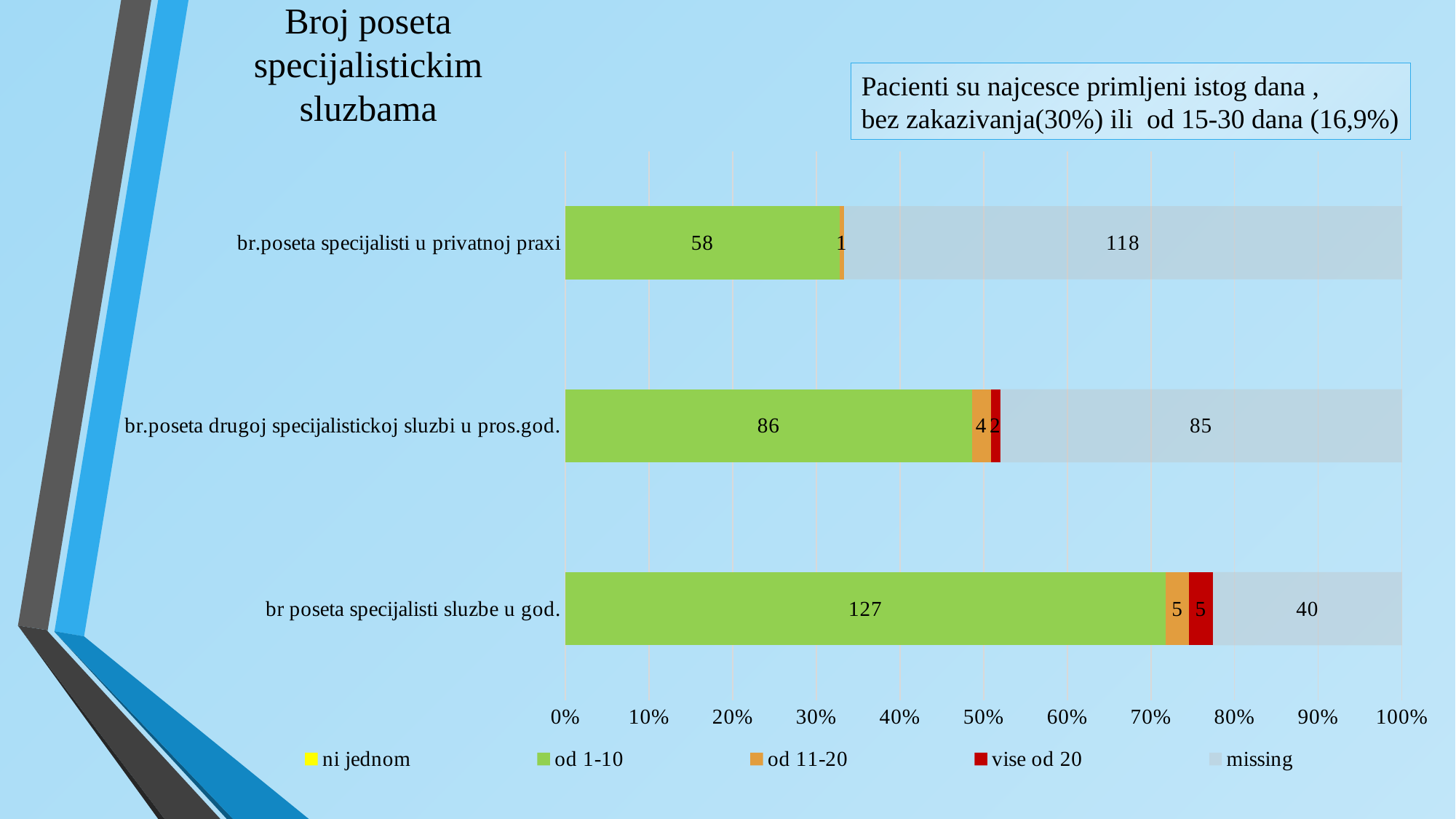
Which category has the lowest 'missing' value? br poseta specijalisti sluzbe u god. Is the share of the 'od 1-10' segment for 'br.poseta specijalisti u privatnoj praxi' greater or less than 40%? less What is the 'vise od 20' value for 'br.poseta drugoj specijalistickoj sluzbi u pros.god.'? 2 What is the 'od 1-10' value for 'br poseta specijalisti sluzbe u god.'? 127 What is the 'od 1-10' value for 'br.poseta specijalisti u privatnoj praxi'? 58 Which category has the highest 'od 1-10' value? br poseta specijalisti sluzbe u god. What kind of chart is shown on the slide? bar chart Which has the larger 'od 1-10' value: 'br.poseta drugoj specijalistickoj sluzbi u pros.god.' or 'br.poseta specijalisti u privatnoj praxi'? br.poseta drugoj specijalistickoj sluzbi u pros.god. How many series does the legend list? 5 What is the difference between the 'missing' value for 'br.poseta specijalisti u privatnoj praxi' and the 'missing' value for 'br poseta specijalisti sluzbe u god.'? 78 What is the 'missing' value for 'br.poseta specijalisti u privatnoj praxi'? 118 How many categories are plotted on the chart? 3